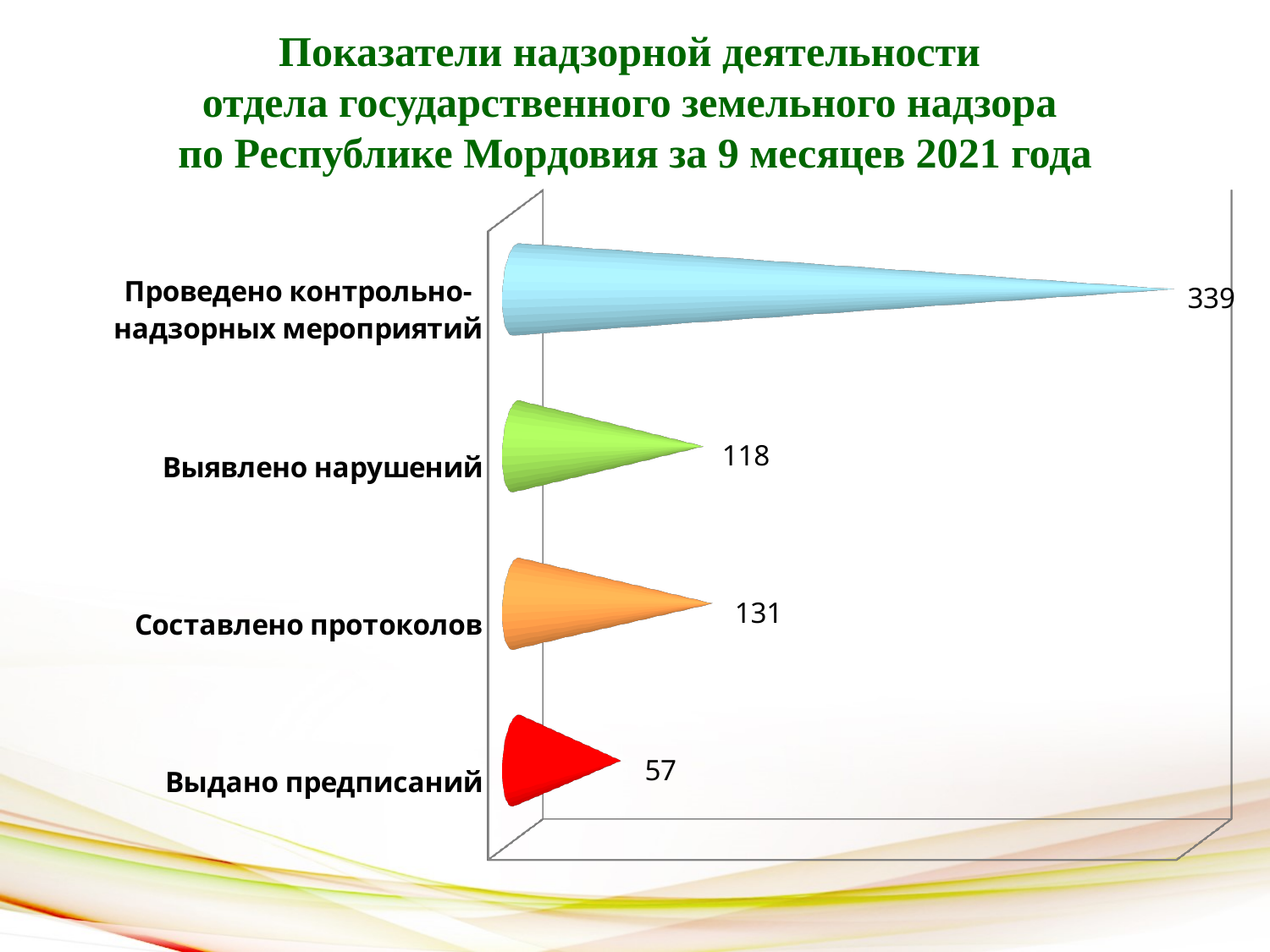
What is the value for «Проведено контрольно-надзорных мероприятий»? 339 What is the difference between «Проведено контрольно-надзорных мероприятий» and «Выявлено нарушений»? 221 What is the value for «Выявлено нарушений»? 118 Which category has the highest value? Проведено контрольно-надзорных мероприятий How many categories are shown in the chart? 4 Which category has the lowest value? Выдано предписаний Which is larger: «Составлено протоколов» or «Выявлено нарушений»? Составлено протоколов What is the difference between «Составлено протоколов» and «Выдано предписаний»? 74 What is the value for «Составлено протоколов»? 131 What colour is the bar for «Выдано предписаний»? Red What kind of chart is shown on the slide? Bar chart What is the value for «Выдано предписаний»? 57